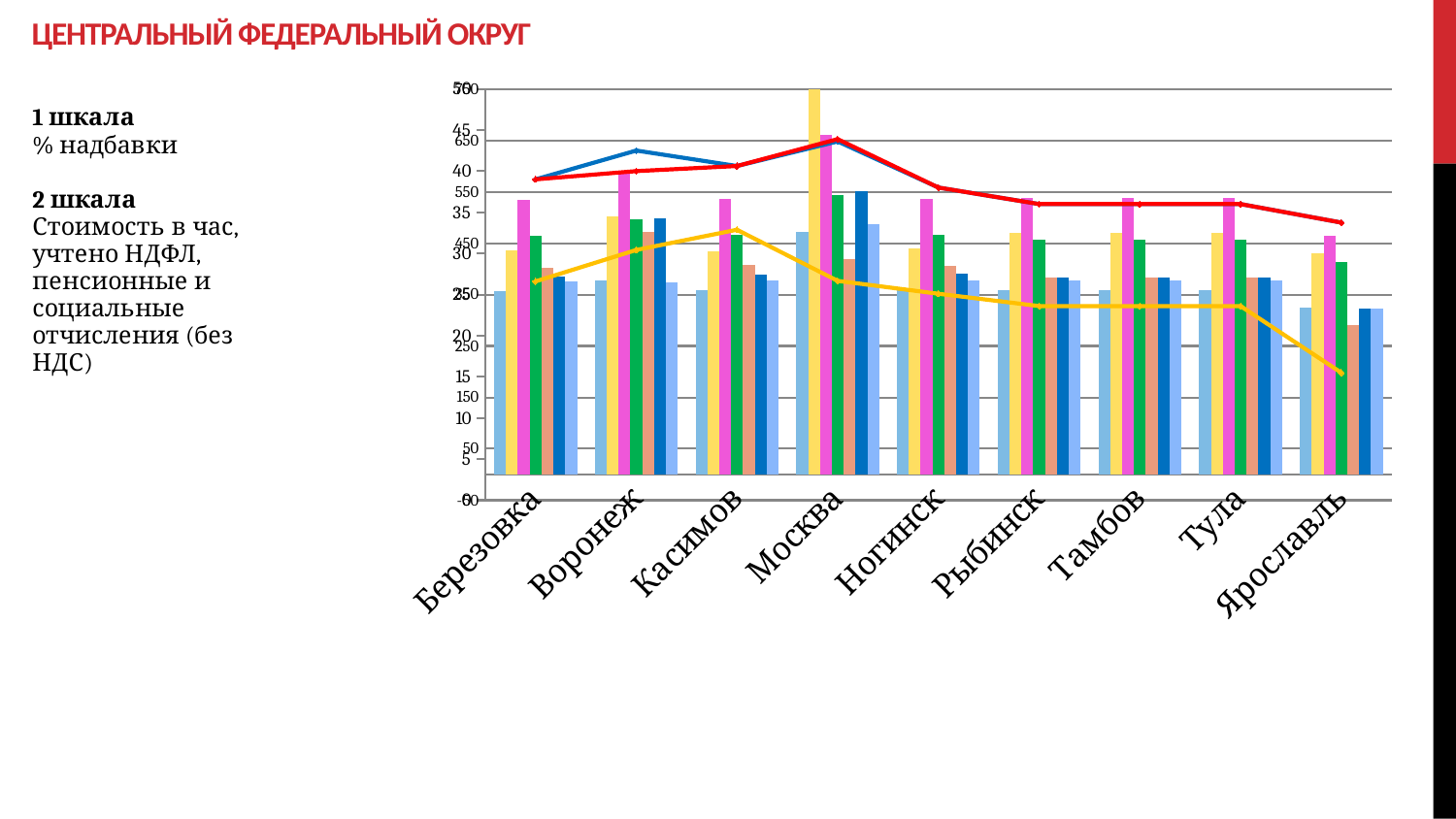
Does the yellow line rise or fall between Тула and Ярославль? Falls Which city has the tallest bar in the chart? Москва Is the red line higher at Москва or at Ярославль? Москва Which city is the first category on the x axis? Березовка At which city does the yellow line reach its lowest point? Ярославль How many cities are shown along the x axis of the chart? 9 What is the title of the slide containing the chart? ЦЕНТРАЛЬНЫЙ ФЕДЕРАЛЬНЫЙ ОКРУГ What kind of chart is shown on the slide? A combined bar and line chart Does the red line rise or fall between Москва and Ярославль? Falls How many lines are plotted over the bars in the chart? 3 At which city does the red line reach its highest point? Москва Is the yellow line higher at Касимов or at Ярославль? Касимов